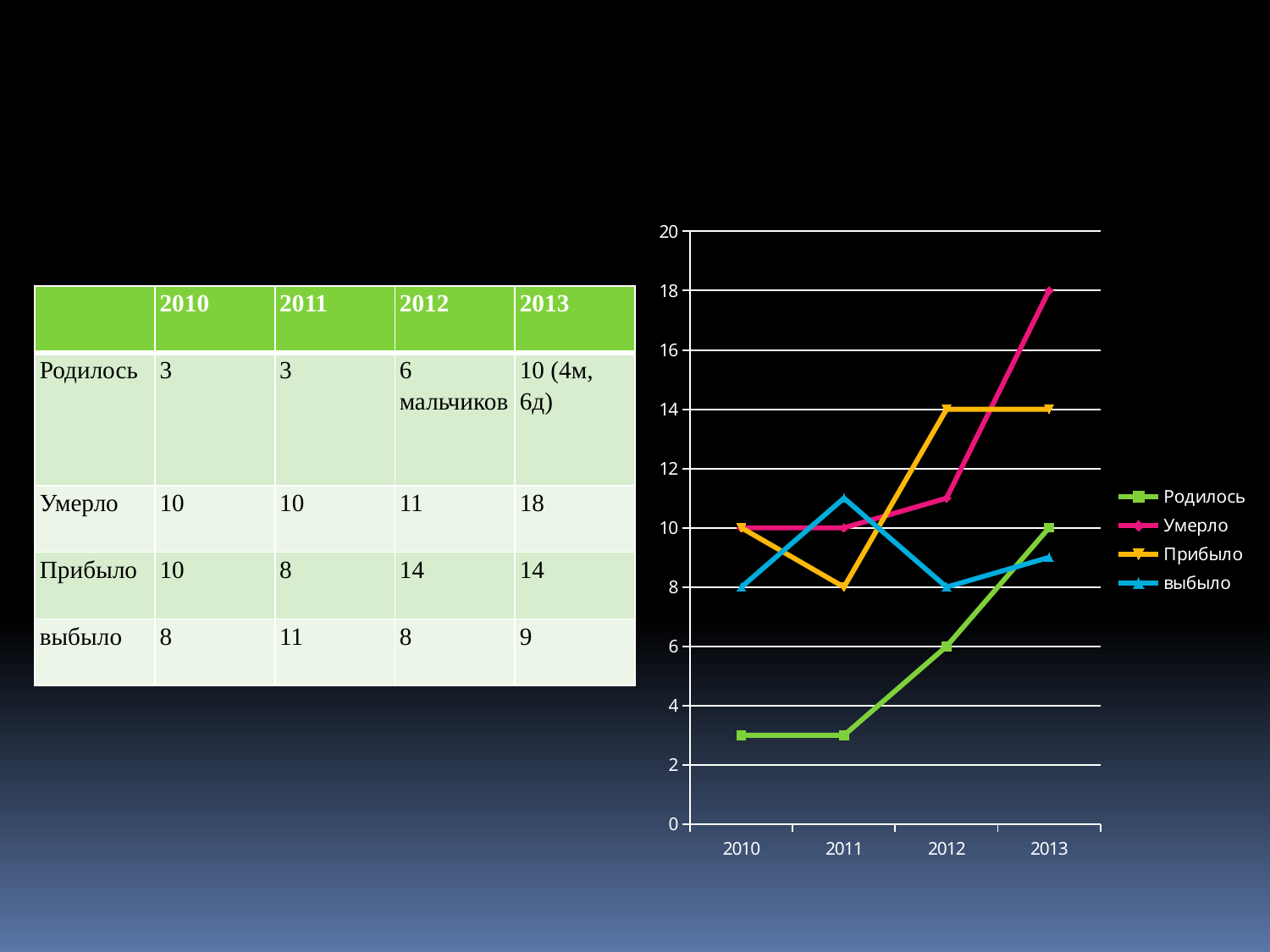
In which year is the Прибыло series lowest? 2011 What is the difference between Умерло and Родилось in 2013? 8 Which series is drawn in pink on the chart? Умерло What kind of chart is shown on the slide? line chart In which year is the Умерло series highest? 2013 What is the value of Умерло in 2013? 18 How many series does the chart legend list? 4 Which is larger in 2011, выбыло or Прибыло? выбыло What is the value of Родилось in 2010? 3 What is the value of Прибыло in 2012? 14 How many years are shown on the x axis of the chart? 4 Does the Родилось series rise or fall from 2011 to 2013? rise